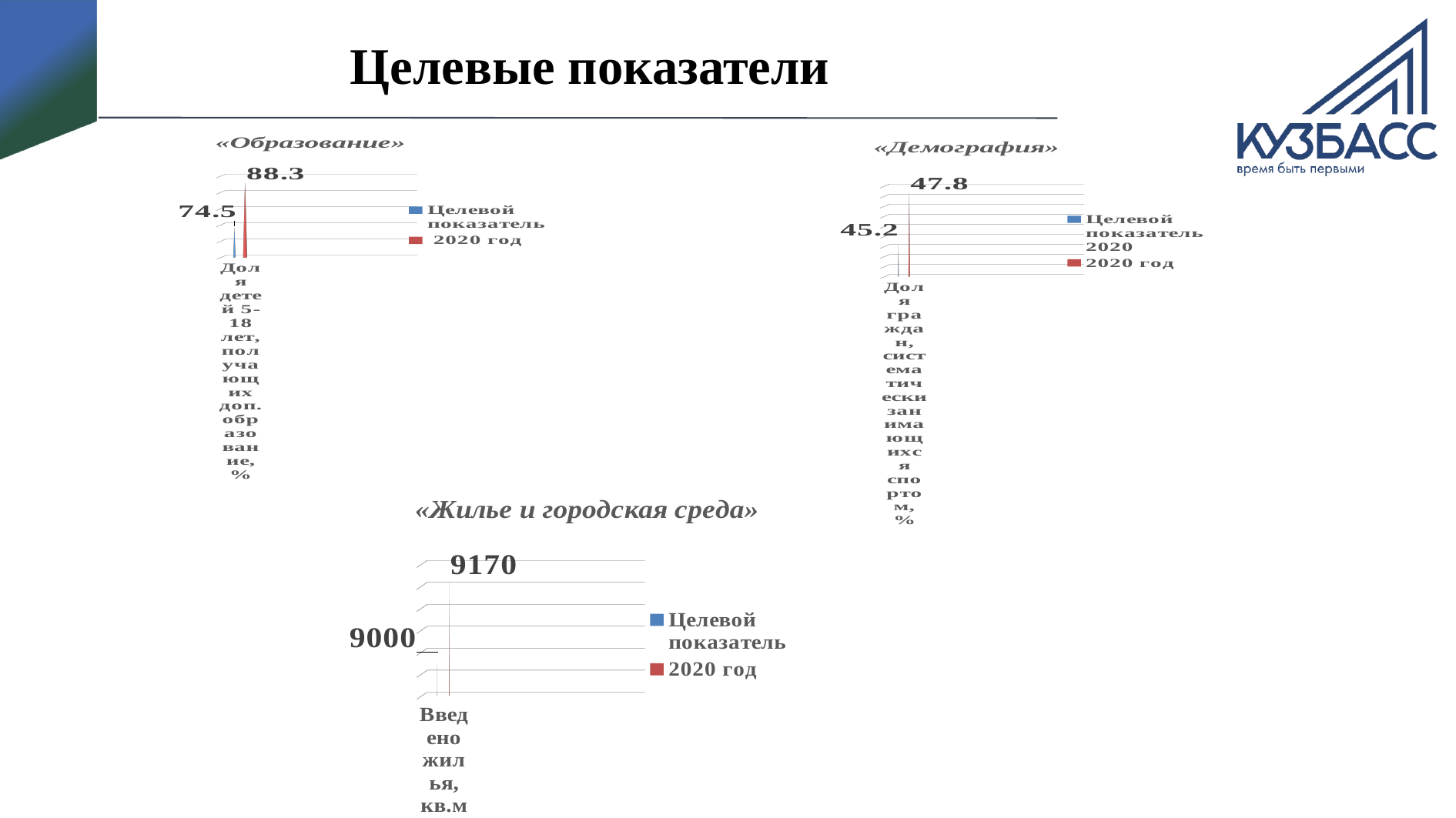
On the «Жилье и городская среда» chart, what is the difference between the «2020 год» value and the «Целевой показатель» value? 170 On the «Демография» chart, which is larger: «Целевой показатель 2020» or «2020 год»? 2020 год What kind of chart is the «Образование» chart? bar chart On the «Демография» chart, what is the value for «2020 год»? 47.8 On the «Жилье и городская среда» chart, what is the value for «Целевой показатель»? 9000 On the «Образование» chart, what is the value for «2020 год»? 88.3 On the «Образование» chart, what is the value for «Целевой показатель»? 74.5 How many charts are shown on the slide? 3 How many series does the legend of the «Жилье и городская среда» chart list? 2 On the «Жилье и городская среда» chart, what is the value for «2020 год»? 9170 On the «Образование» chart, what is the difference between the «2020 год» value and the «Целевой показатель» value? 13.8 On the «Демография» chart, what is the value for «Целевой показатель 2020»? 45.2